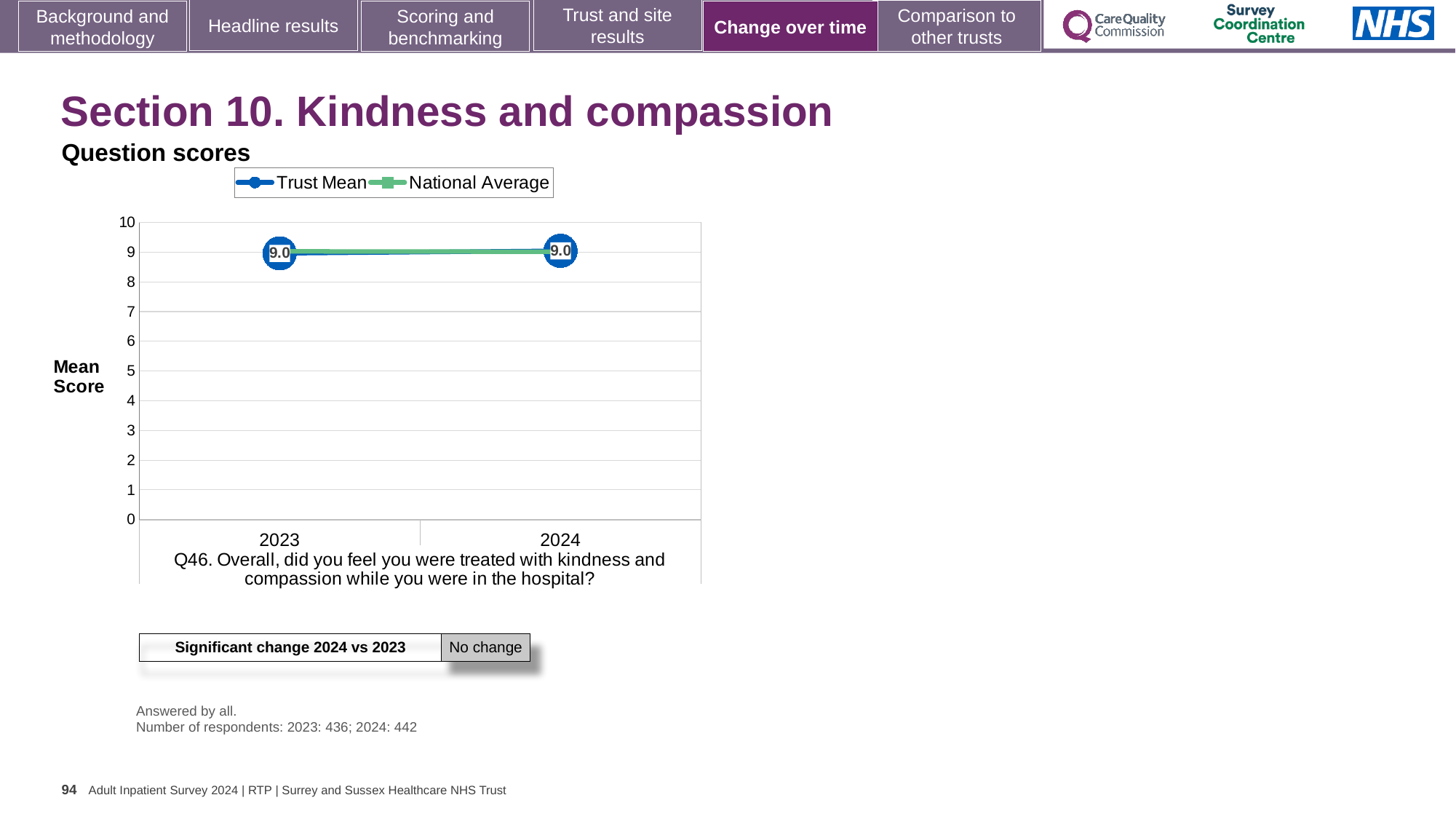
What is the label on the y axis of the chart? Mean Score How many years are plotted on the x axis? 2 Is the National Average value for 2024 greater or less than 5? greater What is the Trust Mean score for 2023? 9.0 What kind of chart is shown on the slide? line chart Does the Trust Mean rise, fall or stay the same from 2023 to 2024? stays the same What is the Trust Mean score for 2024? 9.0 Is the Trust Mean value for 2023 greater or less than 8? greater Which two series are listed in the chart legend? Trust Mean and National Average How many series does the legend list? 2 What is the difference between the Trust Mean scores for 2024 and 2023? 0.0